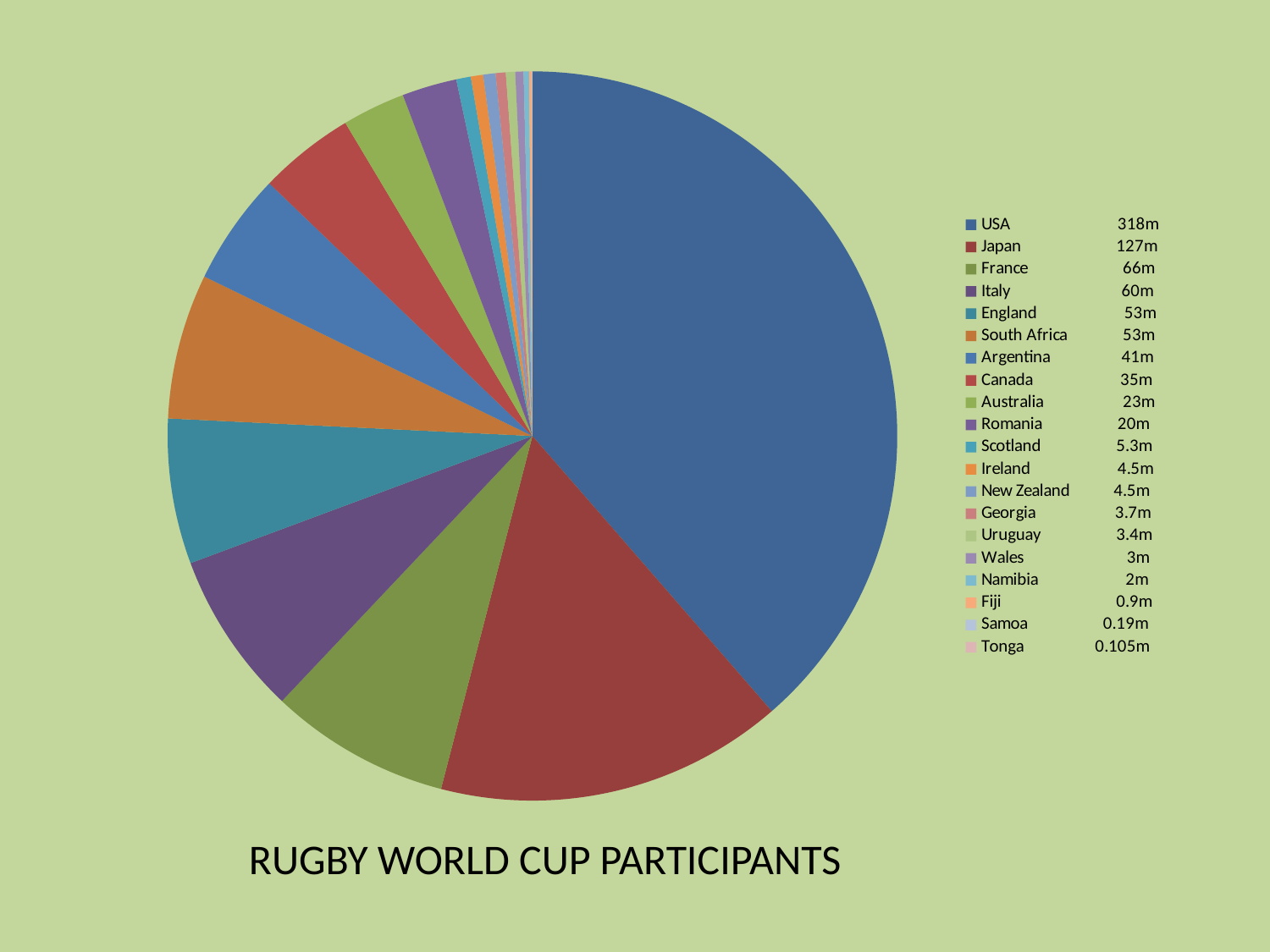
Which is larger, the value for Japan or the value for France? Japan What value is shown for Scotland? 5.3m What is the title of the chart? RUGBY WORLD CUP PARTICIPANTS Which country has the largest slice of the pie? USA What value is shown for Tonga? 0.105m What is the difference between the values for Canada and Australia? 12m What value is shown for the USA? 318m What is the difference between the values for the USA and Japan? 191m Which country has the smallest value in the legend? Tonga What value is shown for Japan? 127m What type of chart is shown on the slide? Pie chart How many countries are listed in the legend? 20